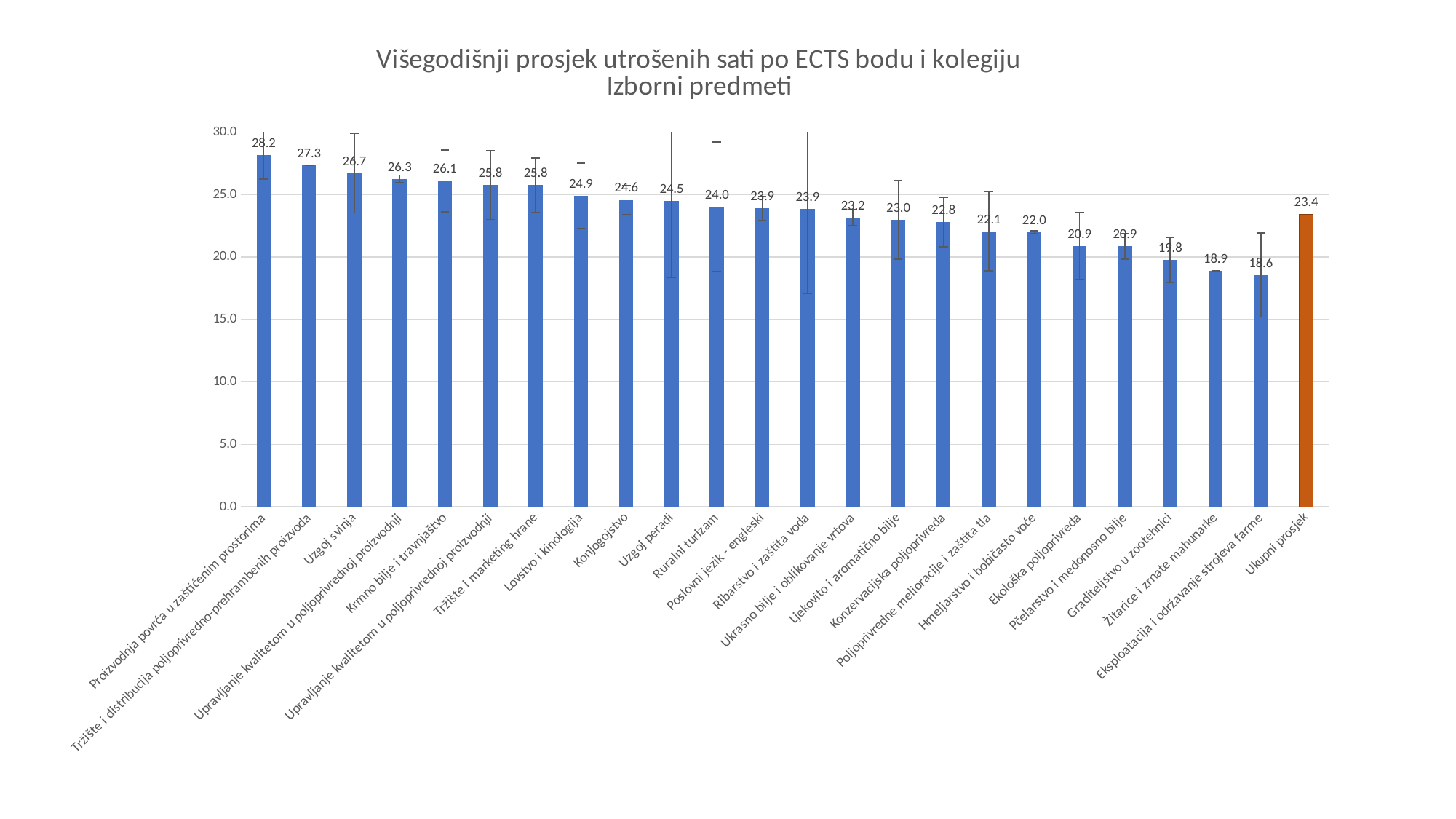
Which category has the lowest value? Eksploatacija i održavanje strojeva farme What is the value for Graditeljstvo u zootehnici? 19.8 What is the value for Ruralni turizam? 24.0 What is the value for Ukupni prosjek? 23.4 What kind of chart is shown on the slide? bar chart What is the value for Uzgoj svinja? 26.7 Which category has the highest value? Proizvodnja povrća u zaštićenim prostorima What is the difference between the values for Proizvodnja povrća u zaštićenim prostorima and Eksploatacija i održavanje strojeva farme? 9.6 Is the value for Žitarice i zrnate mahunarke greater or less than 20.0? less How many bars are shown in the chart? 24 Do the values of the blue bars rise or fall from left to right along the x axis? fall Which is larger, the value for Konjogojstvo or the value for Ekološka poljoprivreda? Konjogojstvo